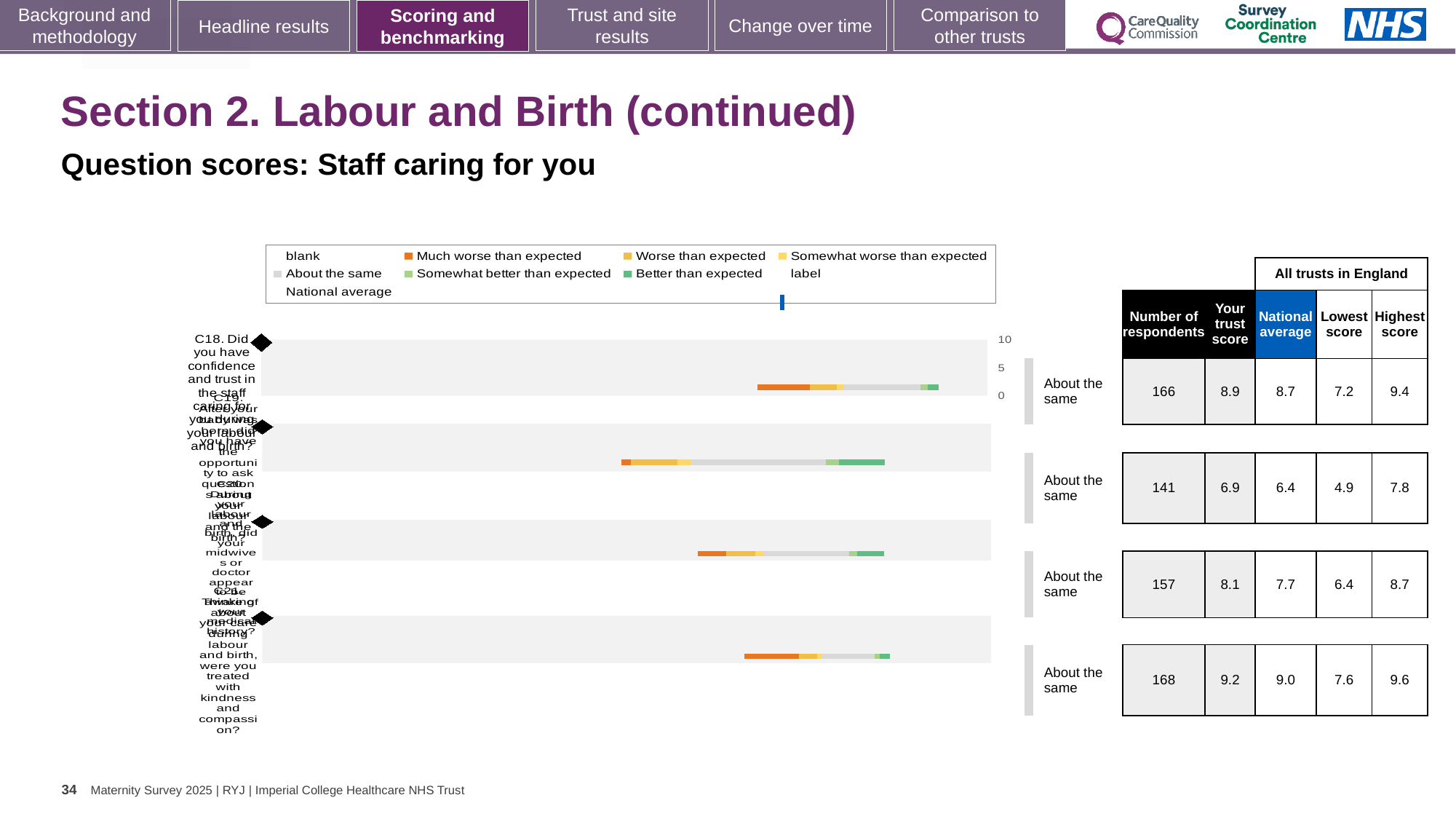
What is the highest value shown on the chart's numeric axis? 10 In the table beside the chart, which row has the lowest 'Your trust score'? second row (C19) In the table beside the chart, which is larger: the number of respondents for the first row (C18) or the third row (C20)? first row (C18) In the chart legend, what colour represents 'Much worse than expected'? orange In the table beside the chart, what is 'Your trust score' for the first row (C18)? 8.9 In the table beside the chart, what is the lowest score for the third row (C20)? 6.4 What kind of chart is shown on the slide? bar chart In the table beside the chart, what is the difference between 'Your trust score' and the national average for the fourth row (C21)? 0.2 In the table beside the chart, what is the number of respondents for the first row (C18)? 166 In the table beside the chart, what is the national average for the second row (C19)? 6.4 How many question bars are plotted in the chart? 4 In the table beside the chart, what is the highest score for the fourth row (C21)? 9.6